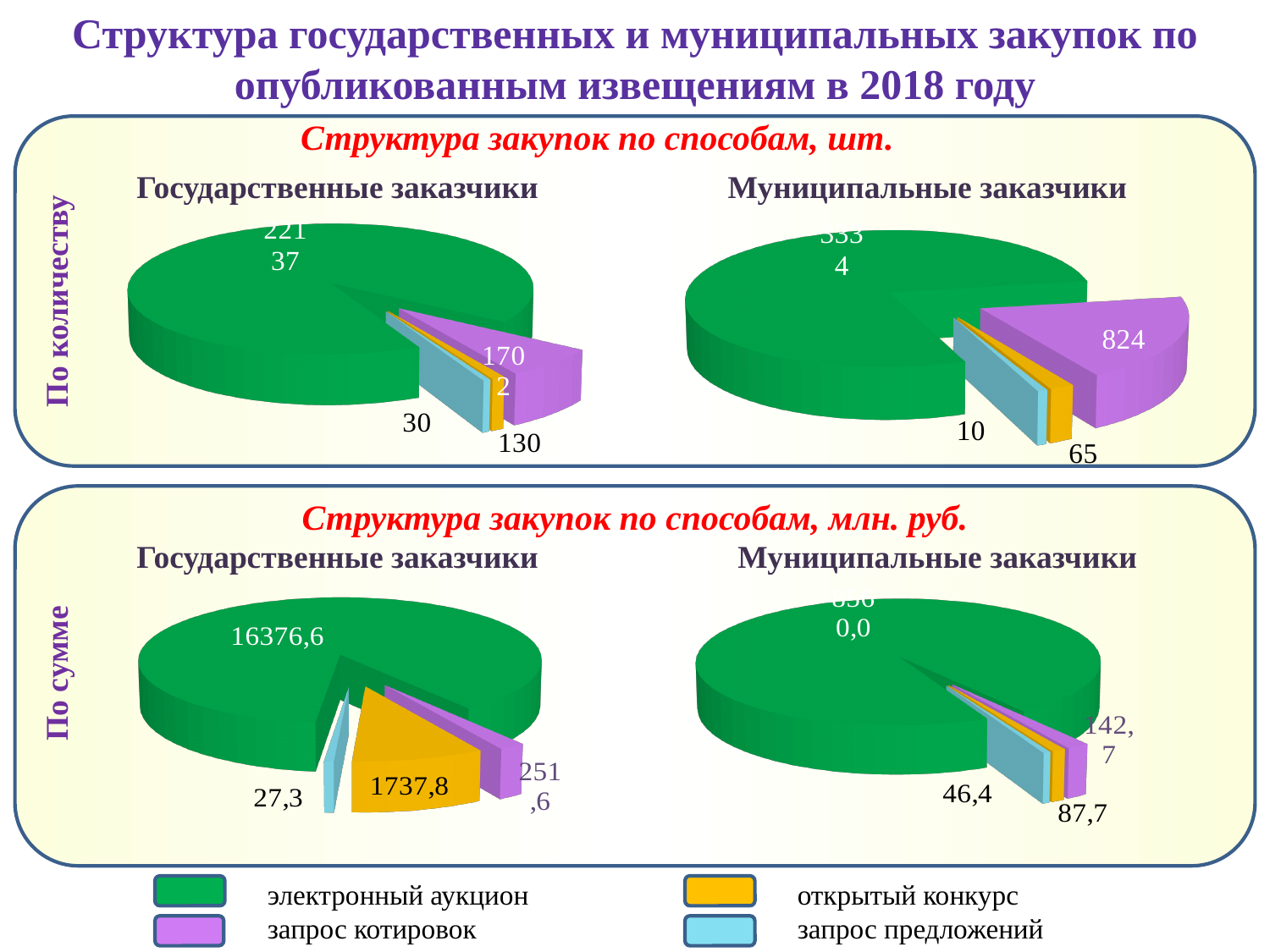
In the top-left pie chart (Государственные заказчики, шт.), what is the difference between открытый конкурс and запрос предложений? 100 In the bottom-left pie chart (Государственные заказчики, млн. руб.), what is the value for открытый конкурс? 1737,8 In the top-right pie chart (Муниципальные заказчики, шт.), which is larger: запрос котировок or открытый конкурс? запрос котировок How many procurement methods does the legend at the bottom of the slide list? 4 In the top-right pie chart (Муниципальные заказчики, шт.), what is the value for запрос котировок? 824 In the bottom-left pie chart (Государственные заказчики, млн. руб.), which procurement method has the largest slice? электронный аукцион In the bottom-right pie chart (Муниципальные заказчики, млн. руб.), what is the difference between открытый конкурс (87,7) and запрос предложений (46,4)? 41,3 In the top-right pie chart (Муниципальные заказчики, шт.), what is the value for открытый конкурс? 65 In the top-left pie chart (Государственные заказчики, шт.), what is the value for открытый конкурс? 130 In the top-left pie chart (Государственные заказчики, шт.), what is the value for запрос предложений? 30 In the bottom-left pie chart (Государственные заказчики, млн. руб.), what is the value for электронный аукцион? 16376,6 What kind of charts are shown on the slide? pie charts